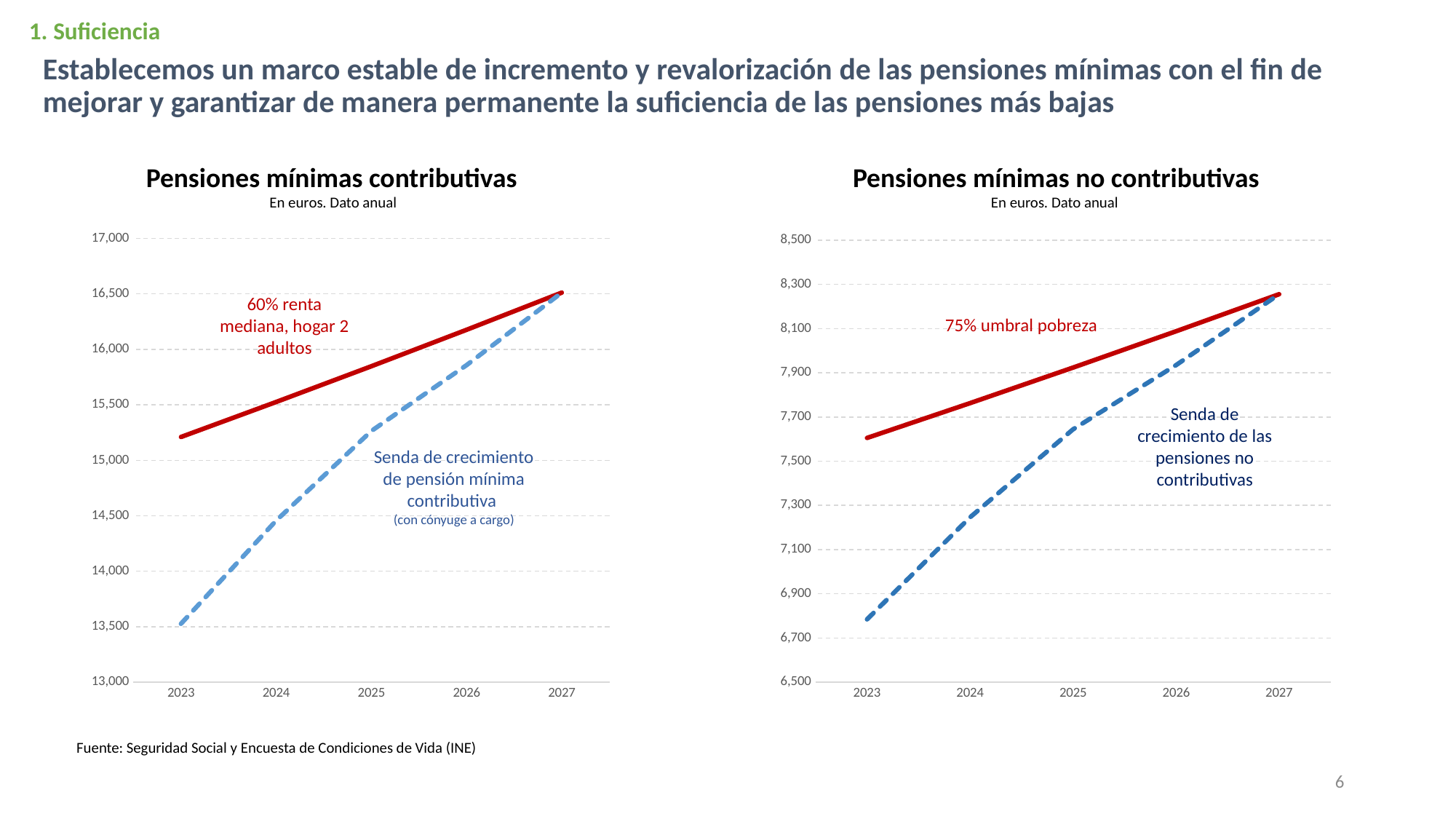
In the 'Pensiones mínimas contributivas' chart, how many years are shown on the x axis? 5 In the 'Pensiones mínimas contributivas' chart, is the 2026 value of the dashed line greater or less than 15,500? greater In the 'Pensiones mínimas no contributivas' chart, which line is higher in 2025, the red line or the dashed line? the red line In the 'Pensiones mínimas no contributivas' chart, is the 2023 value of the dashed line greater or less than 7,100? less In the 'Pensiones mínimas no contributivas' chart, is the 2023 value of the red line greater or less than 7,500? greater What subtitle appears under the title of the 'Pensiones mínimas no contributivas' chart? En euros. Dato anual In the 'Pensiones mínimas no contributivas' chart, what label is given to the red line? 75% umbral pobreza In the 'Pensiones mínimas contributivas' chart, does the dashed line rise or fall from 2023 to 2027? rises In the 'Pensiones mínimas contributivas' chart, which line is higher in 2024, the red line or the dashed line? the red line What kind of chart is 'Pensiones mínimas contributivas'? line chart